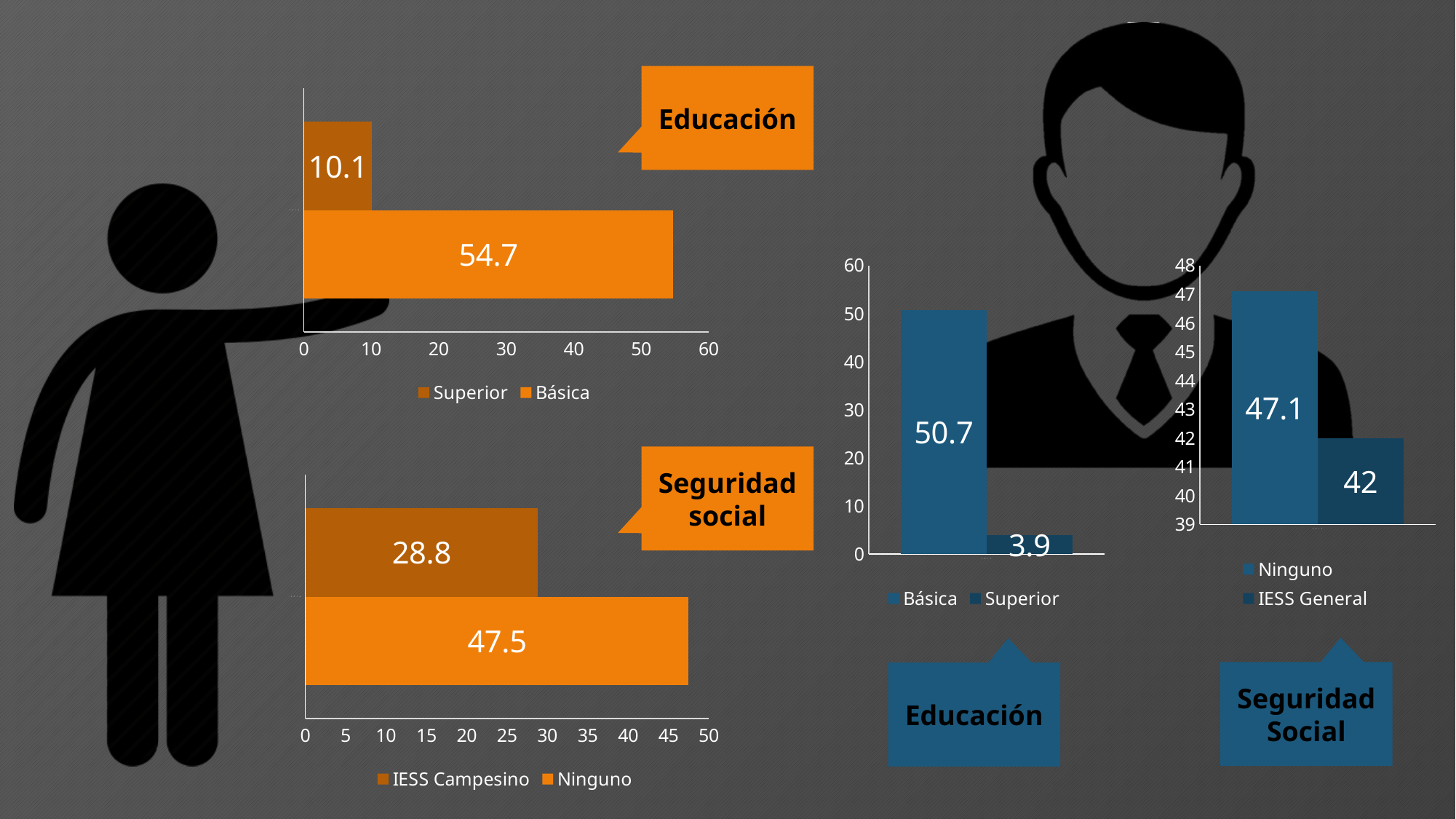
In the blue Educación bar chart on the right, which series has the highest value? Básica In the orange Seguridad social bar chart on the left, which series has the higher value, IESS Campesino or Ninguno? Ninguno In the blue Educación bar chart on the right, what is the value for Superior? 3.9 In the orange Educación bar chart on the left, what is the value for Básica? 54.7 In the blue Seguridad Social bar chart on the right, what is the value for IESS General? 42 In the orange Educación bar chart on the left, what is the difference between the Básica and Superior values? 44.6 In the orange Seguridad social bar chart on the left, how many series does the legend list? 2 In the blue Seguridad Social bar chart on the right, what is the difference between the Ninguno and IESS General values? 5.1 In the orange Educación bar chart on the left, what is the value for Superior? 10.1 What kind of chart is the blue Seguridad Social chart on the right? Bar chart In the orange Seguridad social bar chart on the left, what is the value for IESS Campesino? 28.8 In the blue Educación bar chart on the right, is the value for Básica greater or less than 40? greater